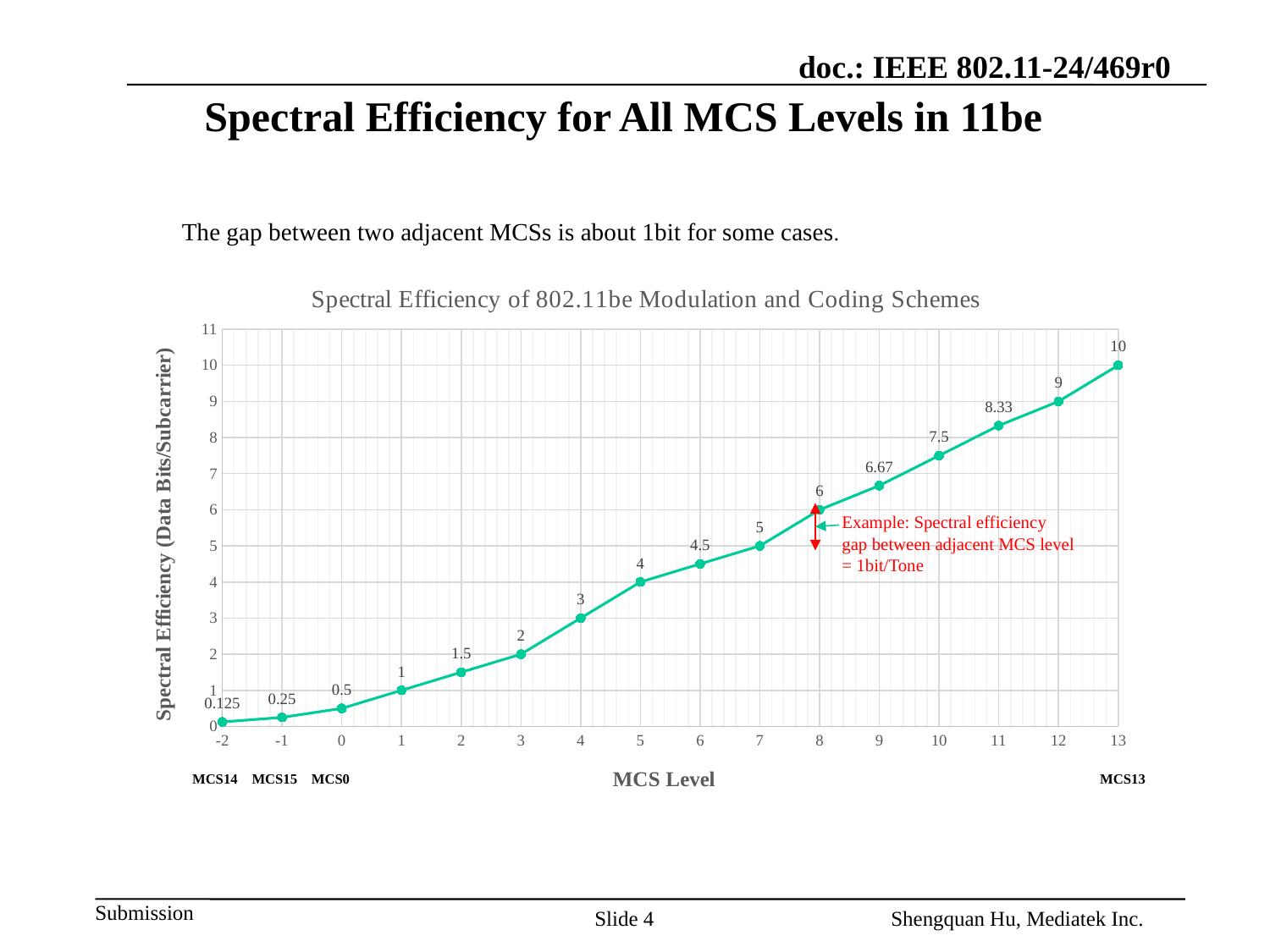
What is the difference in spectral efficiency between MCS level 10 and MCS level 9? 0.83 What is the spectral efficiency value plotted at MCS level -2? 0.125 What is the title of the chart? Spectral Efficiency of 802.11be Modulation and Coding Schemes Which MCS level has the lowest spectral efficiency in the chart? -2 What is the spectral efficiency value plotted at MCS level 8? 6 Which MCS level has the highest spectral efficiency in the chart? 13 Which has a higher spectral efficiency, MCS level 4 or MCS level 6? MCS level 6 What is the difference in spectral efficiency between MCS level 8 and MCS level 7? 1 How many data points are plotted on the chart? 16 What is the spectral efficiency value plotted at MCS level 11? 8.33 What type of chart is shown on the slide? Line chart Do the spectral efficiency values rise or fall as the MCS level increases? Rise